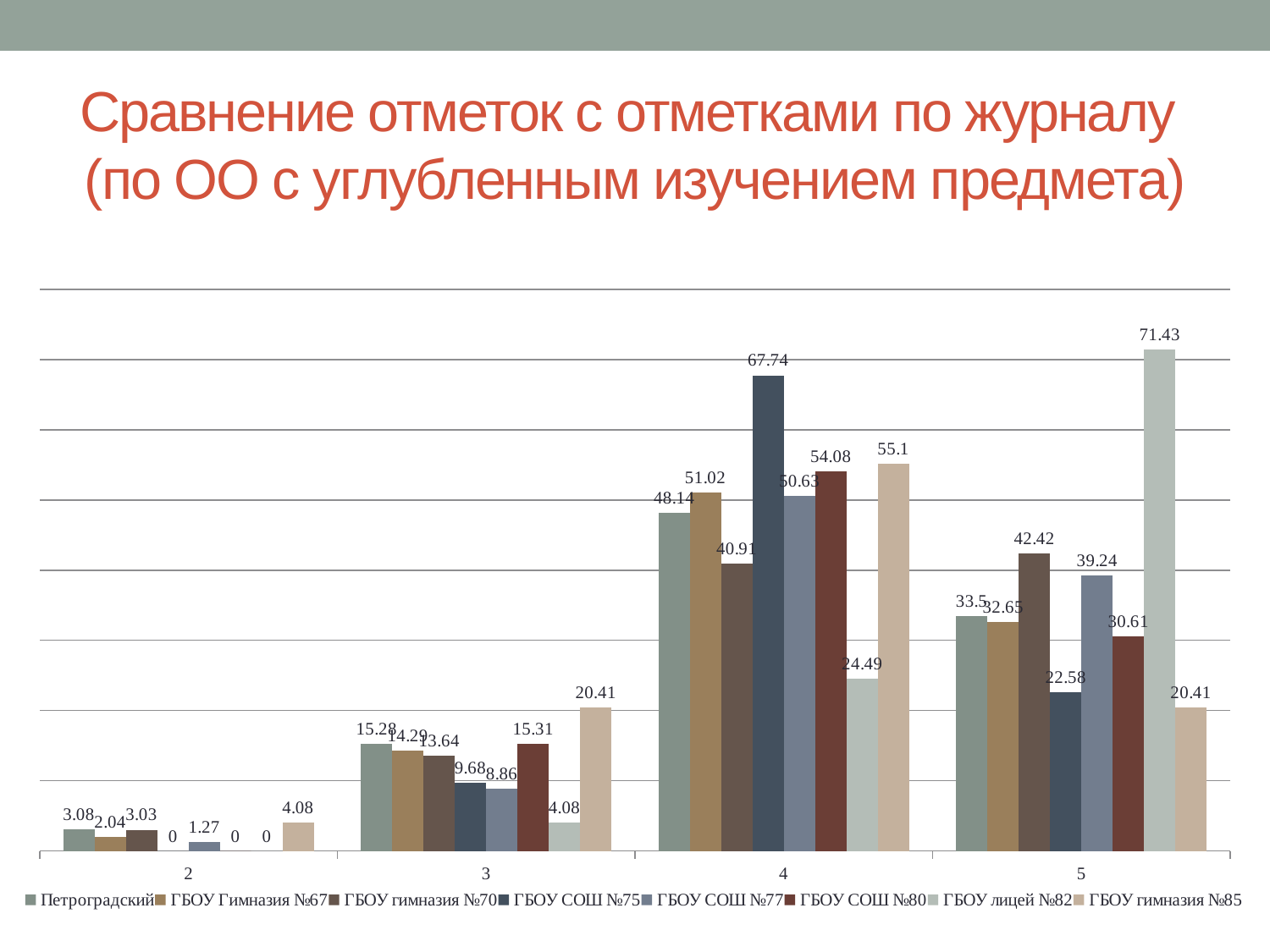
What is the value for Петроградский in category 2? 3.08 What is the value for ГБОУ лицей №82 in category 5? 71.43 In category 5, which series has the lowest value? ГБОУ гимназия №85 How many series does the legend list? 8 What is the difference between the values for ГБОУ лицей №82 in category 5 and category 4? 46.94 What is the value for ГБОУ СОШ №75 in category 4? 67.74 In category 4, which series has the highest value? ГБОУ СОШ №75 For ГБОУ лицей №82, which category has the highest value? 5 What is the value for ГБОУ гимназия №85 in category 3? 20.41 What kind of chart is shown on the slide? bar chart In category 5, which is larger: Петроградский or ГБОУ гимназия №70? ГБОУ гимназия №70 How many categories are shown on the x axis? 4